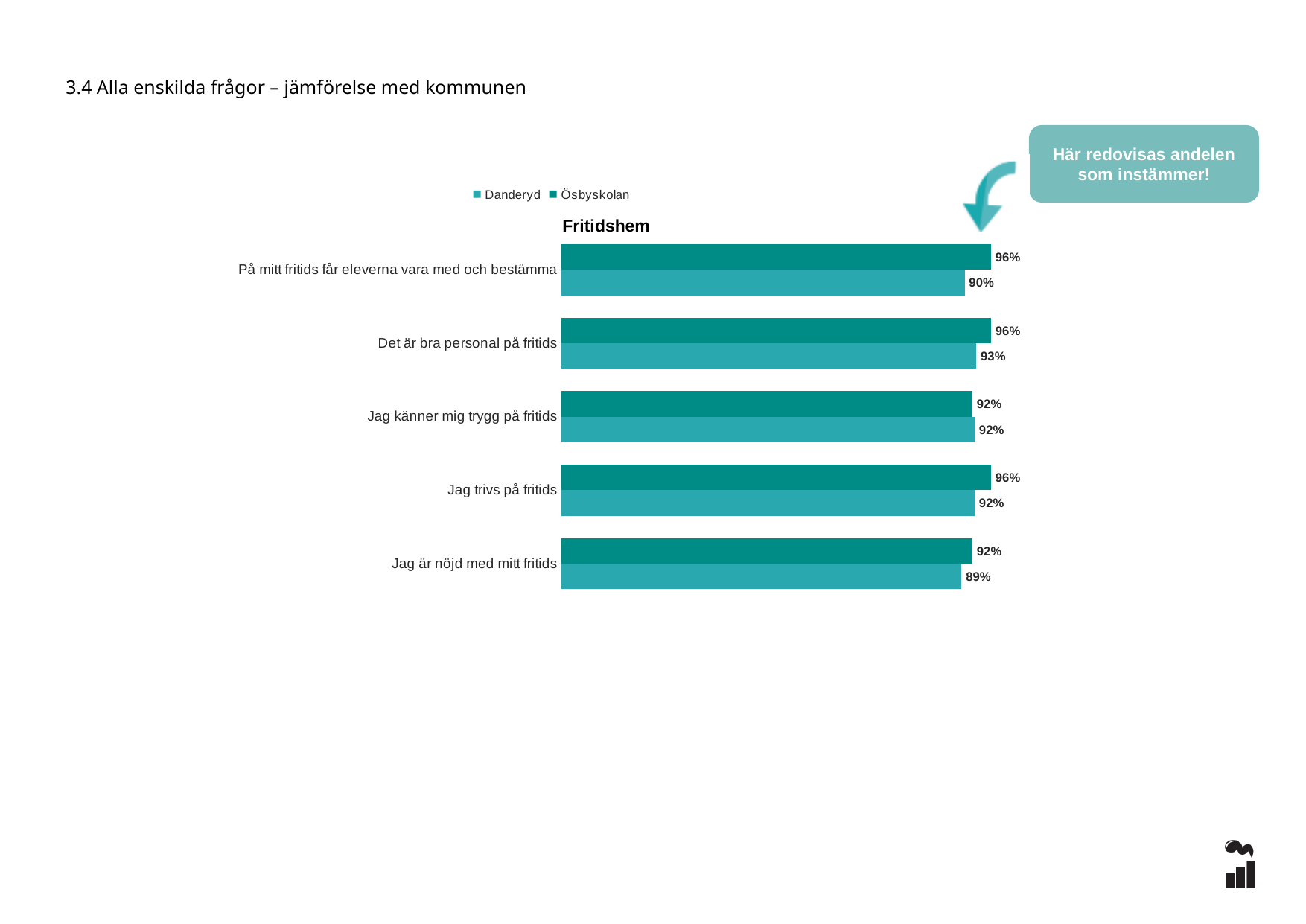
What is the difference between the Ösbyskolan and Danderyd values for 'På mitt fritids får eleverna vara med och bestämma'? 6 percentage points Which category has the lowest Danderyd value? Jag är nöjd med mitt fritids What is the Danderyd value for 'På mitt fritids får eleverna vara med och bestämma'? 90% What is the Ösbyskolan value for 'Jag trivs på fritids'? 96% What is the difference between the Ösbyskolan and Danderyd values for 'Jag är nöjd med mitt fritids'? 3 percentage points What type of chart is shown on the slide? bar chart What is the Ösbyskolan value for 'Jag är nöjd med mitt fritids'? 92% What is the Danderyd value for 'Det är bra personal på fritids'? 93% What is the title of the chart? Fritidshem Which is larger for 'Jag trivs på fritids', the Ösbyskolan value or the Danderyd value? Ösbyskolan How many categories (questions) are shown in the chart? 5 How many series does the legend list? 2